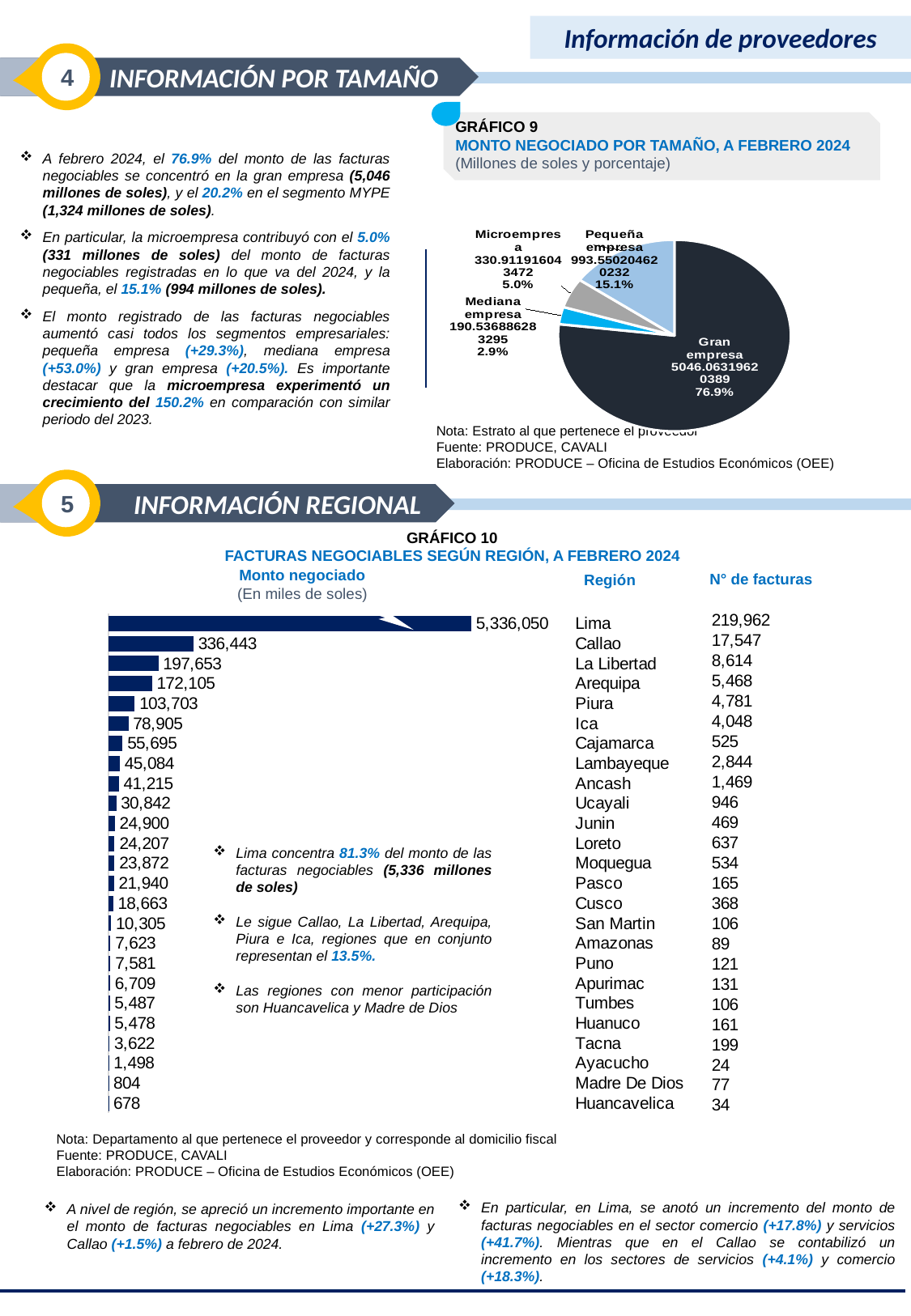
In Gráfico 10 (Facturas negociables según región), what is the monto negociado for Piura? 103,703 In Gráfico 9 (Monto negociado por tamaño), how many segments does the pie have? 4 In Gráfico 9 (Monto negociado por tamaño), what percentage share does Pequeña empresa have? 15.1% In Gráfico 10 (Facturas negociables según región), which region has the highest monto negociado? Lima In Gráfico 9 (Monto negociado por tamaño), what percentage share does Gran empresa have? 76.9% In Gráfico 9 (Monto negociado por tamaño), which segment has the smallest share? Mediana empresa In Gráfico 10 (Facturas negociables según región), how many regions are plotted? 25 In Gráfico 9 (Monto negociado por tamaño), what kind of chart is shown? Pie chart In Gráfico 10 (Facturas negociables según región), what is the monto negociado for Callao? 336,443 In Gráfico 10 (Facturas negociables según región), what is the difference in monto negociado between La Libertad and Arequipa? 25,548 In Gráfico 10 (Facturas negociables según región), which has a larger monto negociado, Ica or Cajamarca? Ica In Gráfico 10 (Facturas negociables según región), which region has the lowest monto negociado? Huancavelica